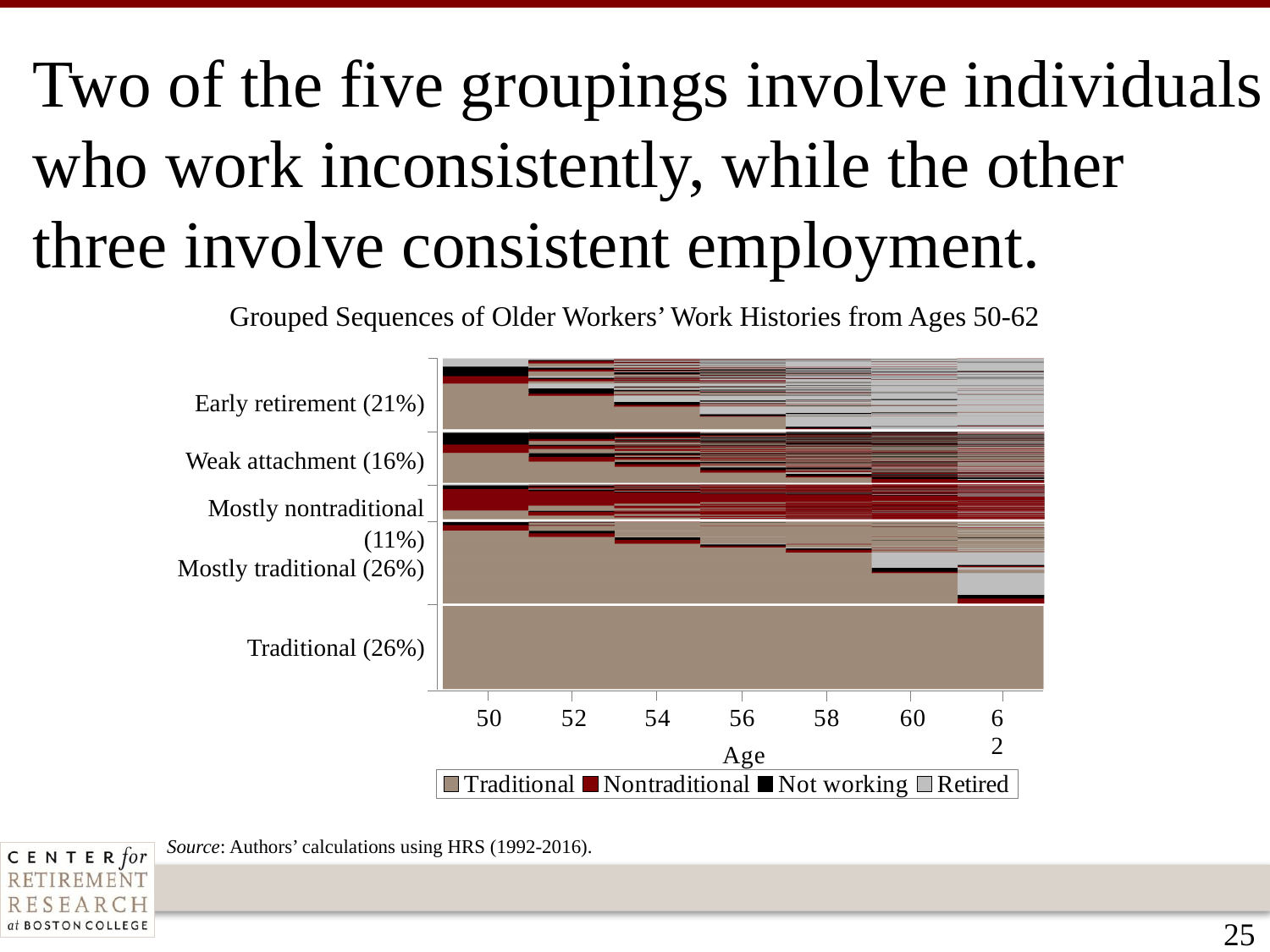
What share of older workers falls into the Mostly nontraditional group? 11% What share of older workers falls into the Early retirement group? 21% What share of older workers falls into the Mostly traditional group? 26% Which group has a larger share, Early retirement or Weak attachment? Early retirement What variable is shown on the x axis? Age What is the title of the chart? Grouped Sequences of Older Workers' Work Histories from Ages 50-62 How many groupings are shown on the chart? 5 How many work-status categories does the legend list? 4 What kind of chart is shown on the slide? Bar chart Which grouping has the smallest share of older workers? Mostly nontraditional (11%) How many percentage points larger is the Early retirement group than the Weak attachment group? 5 percentage points What share of older workers falls into the Weak attachment group? 16%